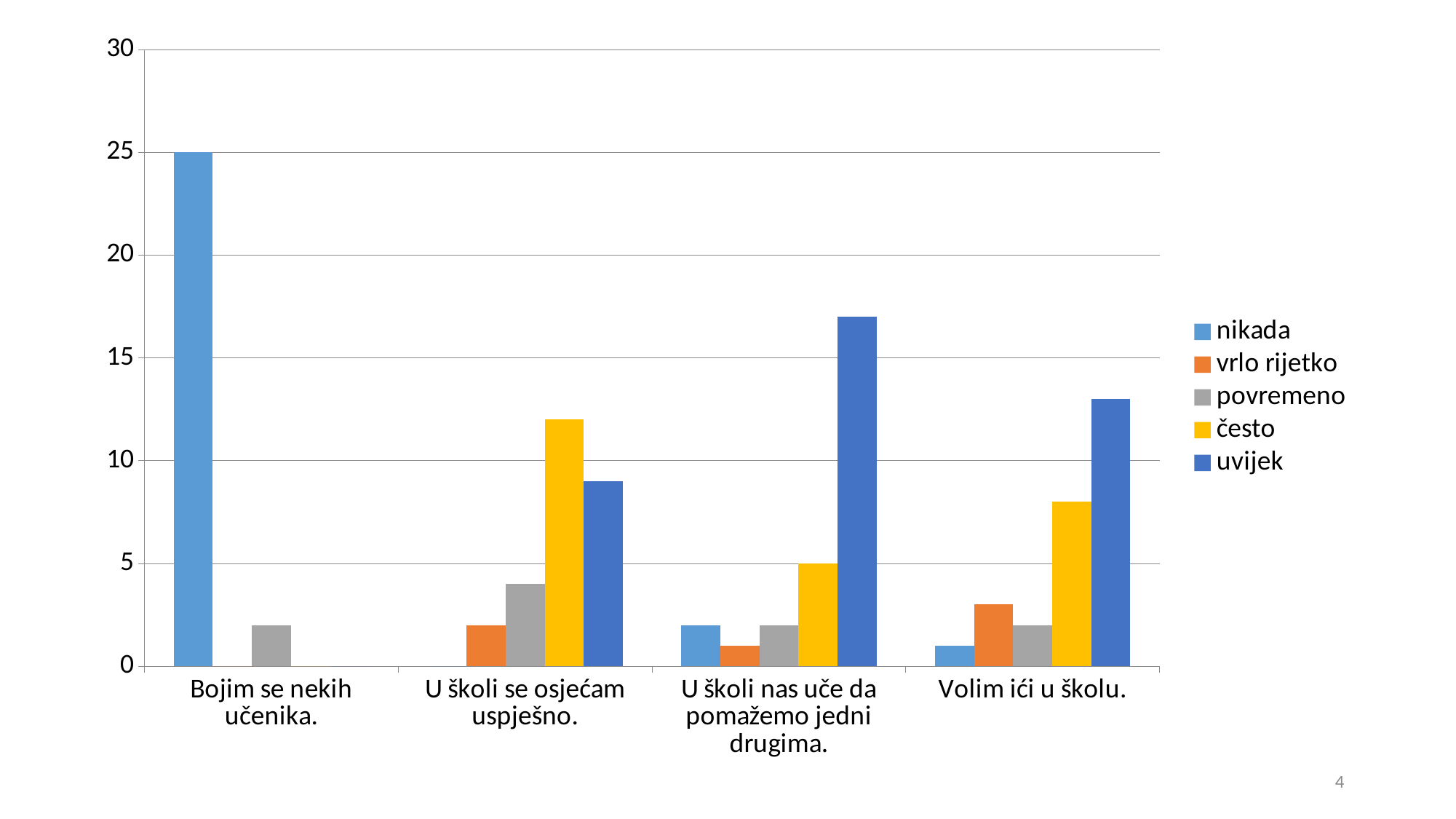
Is the 'često' value for 'U školi se osjećam uspješno.' greater or less than 10? greater Is the 'uvijek' value for 'Volim ići u školu.' greater or less than 15? less Which category has the highest 'uvijek' bar? U školi nas uče da pomažemo jedni drugima. What is the value of the 'često' bar for 'U školi nas uče da pomažemo jedni drugima.'? 5 How many categories are shown on the x axis? 4 What kind of chart is shown on the slide? bar chart Is the 'uvijek' value for 'U školi nas uče da pomažemo jedni drugima.' greater or less than 15? greater Which is larger for 'U školi se osjećam uspješno.': the 'često' bar or the 'uvijek' bar? često What is the value of the 'nikada' bar for 'Bojim se nekih učenika.'? 25 How many series does the legend list? 5 Which category has the highest 'nikada' bar? Bojim se nekih učenika. Which is larger for 'Volim ići u školu.': the 'često' bar or the 'uvijek' bar? uvijek